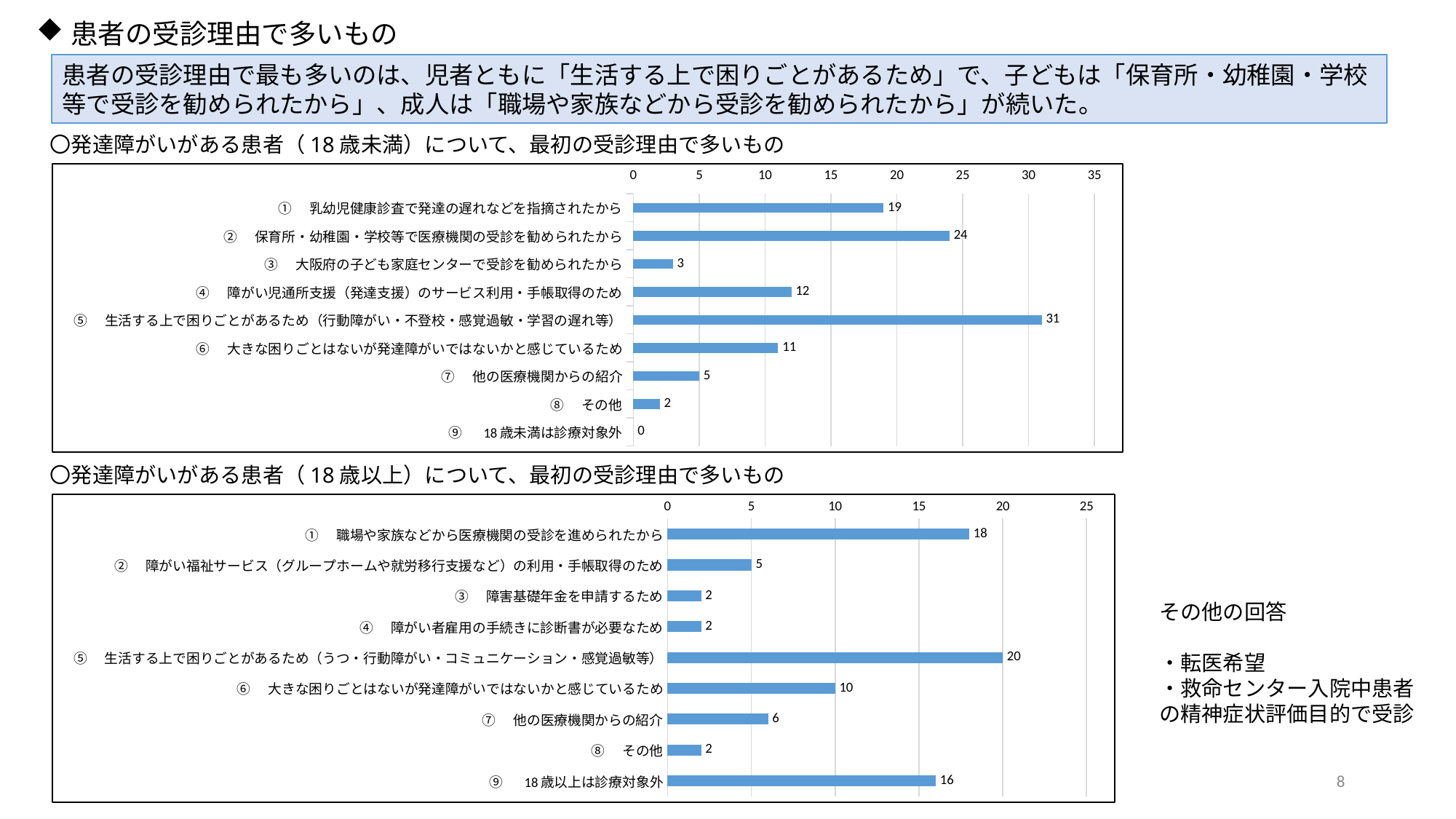
In the bottom chart (18歳以上), what is the difference between ⑤ (20) and ① (18)? 2 In the top chart (18歳未満), what is the difference between ⑤ (31) and ② (24)? 7 In the bottom chart (18歳以上), which reason has the highest value? ⑤ 生活する上で困りごとがあるため（うつ・行動障がい・コミュニケーション・感覚過敏等） In the top chart (18歳未満), what is the value for ② 保育所・幼稚園・学校等で医療機関の受診を勧められたから? 24 In the bottom chart (18歳以上), what is the value for ① 職場や家族などから医療機関の受診を進められたから? 18 In the top chart (18歳未満), what is the value for ⑤ 生活する上で困りごとがあるため? 31 How many categories are plotted in the top chart (18歳未満)? 9 What type of chart is the top chart (18歳未満)? Bar chart In the bottom chart (18歳以上), which is larger: ⑥ 大きな困りごとはないが発達障がいではないかと感じているため or ⑦ 他の医療機関からの紹介? ⑥ 大きな困りごとはないが発達障がいではないかと感じているため In the bottom chart (18歳以上), what is the value for ⑨ 18歳以上は診療対象外? 16 In the top chart (18歳未満), which reason has the highest value? ⑤ 生活する上で困りごとがあるため（行動障がい・不登校・感覚過敏・学習の遅れ等） In the top chart (18歳未満), which reason has the lowest value? ⑨ 18歳未満は診療対象外